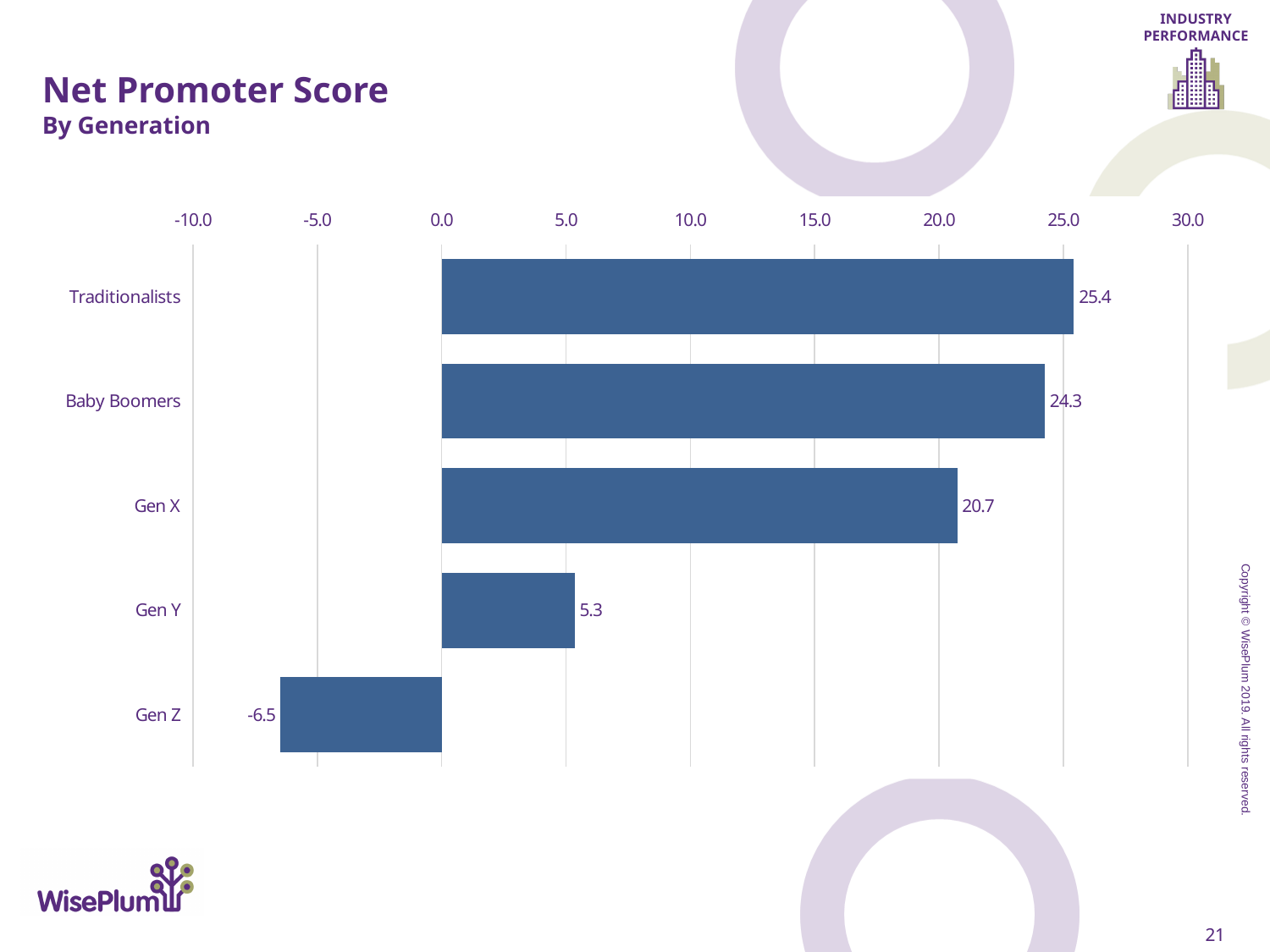
What is the title of the chart? Net Promoter Score By Generation Which generation has the lowest Net Promoter Score? Gen Z How many generations are shown in the chart? 5 Which has a higher Net Promoter Score, Baby Boomers or Gen X? Baby Boomers Is the Net Promoter Score for Gen X greater or less than 15.0? greater What is the Net Promoter Score for Gen Y? 5.3 What is the Net Promoter Score for Gen Z? -6.5 What is the difference between the Net Promoter Scores of Gen X and Gen Y? 15.4 What is the Net Promoter Score for Traditionalists? 25.4 Which generation has the highest Net Promoter Score? Traditionalists What kind of chart is shown on the slide? Bar chart What is the difference between the Net Promoter Scores of Traditionalists and Baby Boomers? 1.1